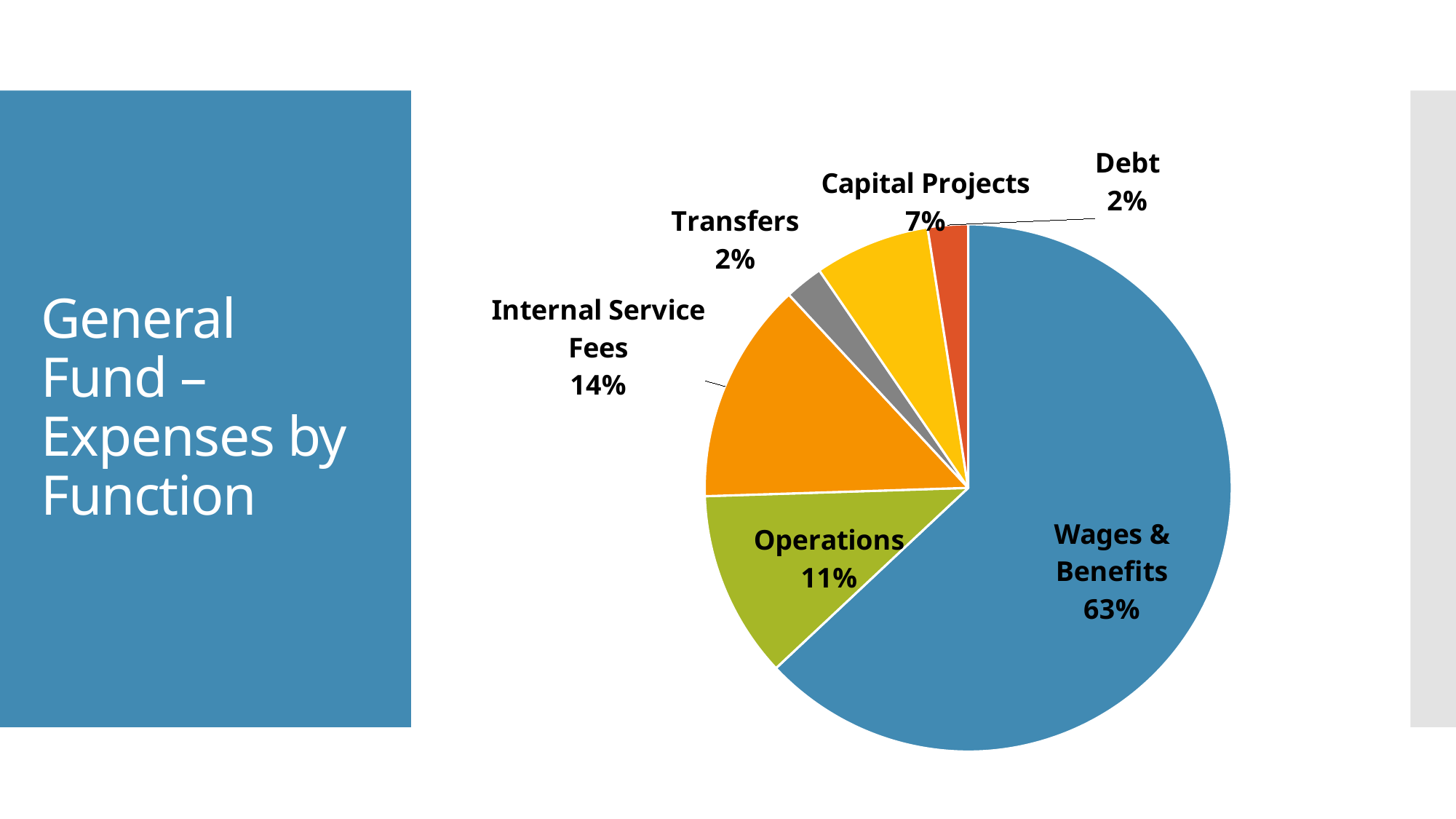
What kind of chart is shown on the slide? pie chart What share of General Fund expenses goes to Wages & Benefits? 63% What percentage is shown for Internal Service Fees? 14% What percentage is shown for Capital Projects? 7% What percentage is shown for Operations? 11% What is the difference in percentage points between Internal Service Fees and Operations? 3% What is the difference in percentage points between Wages & Benefits and Internal Service Fees? 49% Which is larger, Capital Projects or Operations? Operations How many slices does the pie chart have? 6 Which category has the largest share of the pie? Wages & Benefits What is the title of the slide containing the chart? General Fund – Expenses by Function What colour is the Wages & Benefits slice? blue